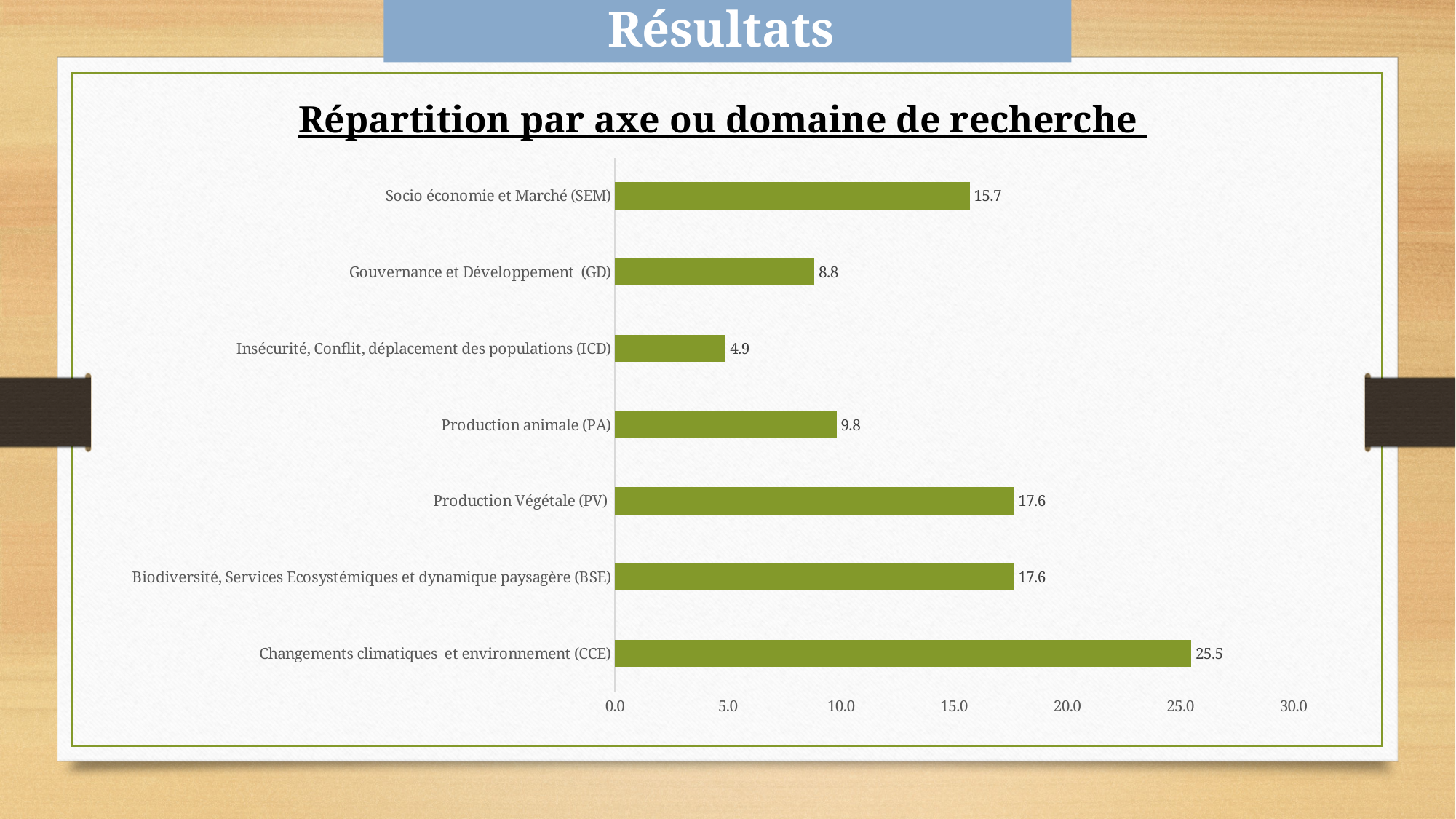
What is the value for Gouvernance et Développement (GD)? 8.8 Which is larger, the value for Socio économie et Marché (SEM) or the value for Production animale (PA)? Socio économie et Marché (SEM) What is the value for Changements climatiques et environnement (CCE)? 25.5 What is the value for Socio économie et Marché (SEM)? 15.7 What is the difference between the values for Changements climatiques et environnement (CCE) and Production Végétale (PV)? 7.9 How many categories are shown in the chart? 7 What is the value for Insécurité, Conflit, déplacement des populations (ICD)? 4.9 What is the title of the chart? Répartition par axe ou domaine de recherche What kind of chart is shown on the slide? Bar chart Which category has the highest value? Changements climatiques et environnement (CCE) Which category has the lowest value? Insécurité, Conflit, déplacement des populations (ICD) What is the value for Production animale (PA)? 9.8